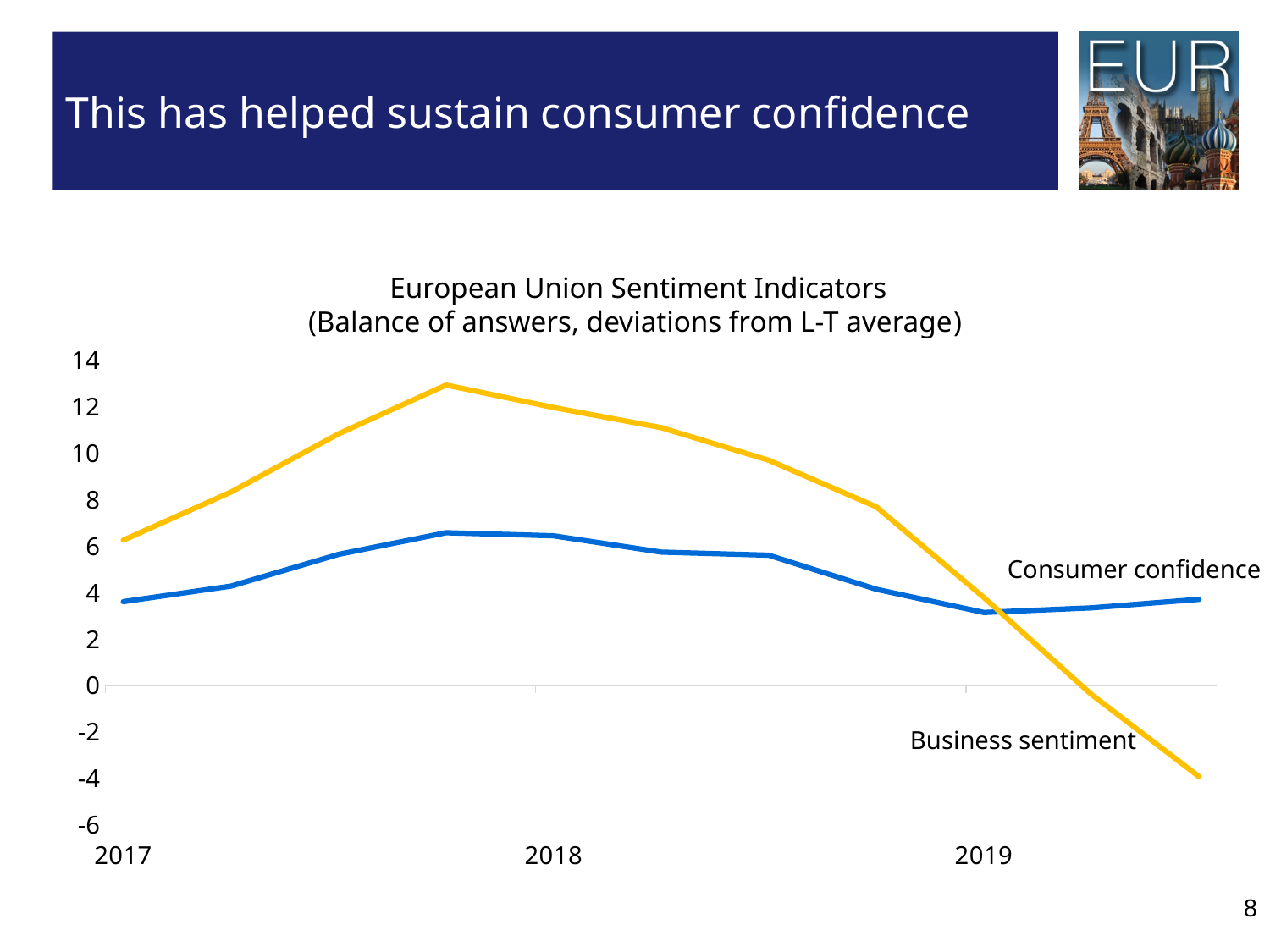
Does Consumer confidence rise or fall between 2017 and 2018? rise What is the title of the chart? European Union Sentiment Indicators (Balance of answers, deviations from L-T average) How many years are labelled on the x axis? 3 Does Business sentiment rise or fall between 2018 and the end of the chart? fall How many series are plotted on the chart? 2 Is the value of Business sentiment at the right-hand end of the chart greater or less than 0? less Is the value of Consumer confidence at 2018 greater or less than 4? greater At 2018, which series is higher, Business sentiment or Consumer confidence? Business sentiment What kind of chart is shown on the slide? line chart At the right-hand end of the chart, which series is higher, Business sentiment or Consumer confidence? Consumer confidence Which series is drawn in yellow? Business sentiment Is the value of Business sentiment at 2018 greater or less than 10? greater